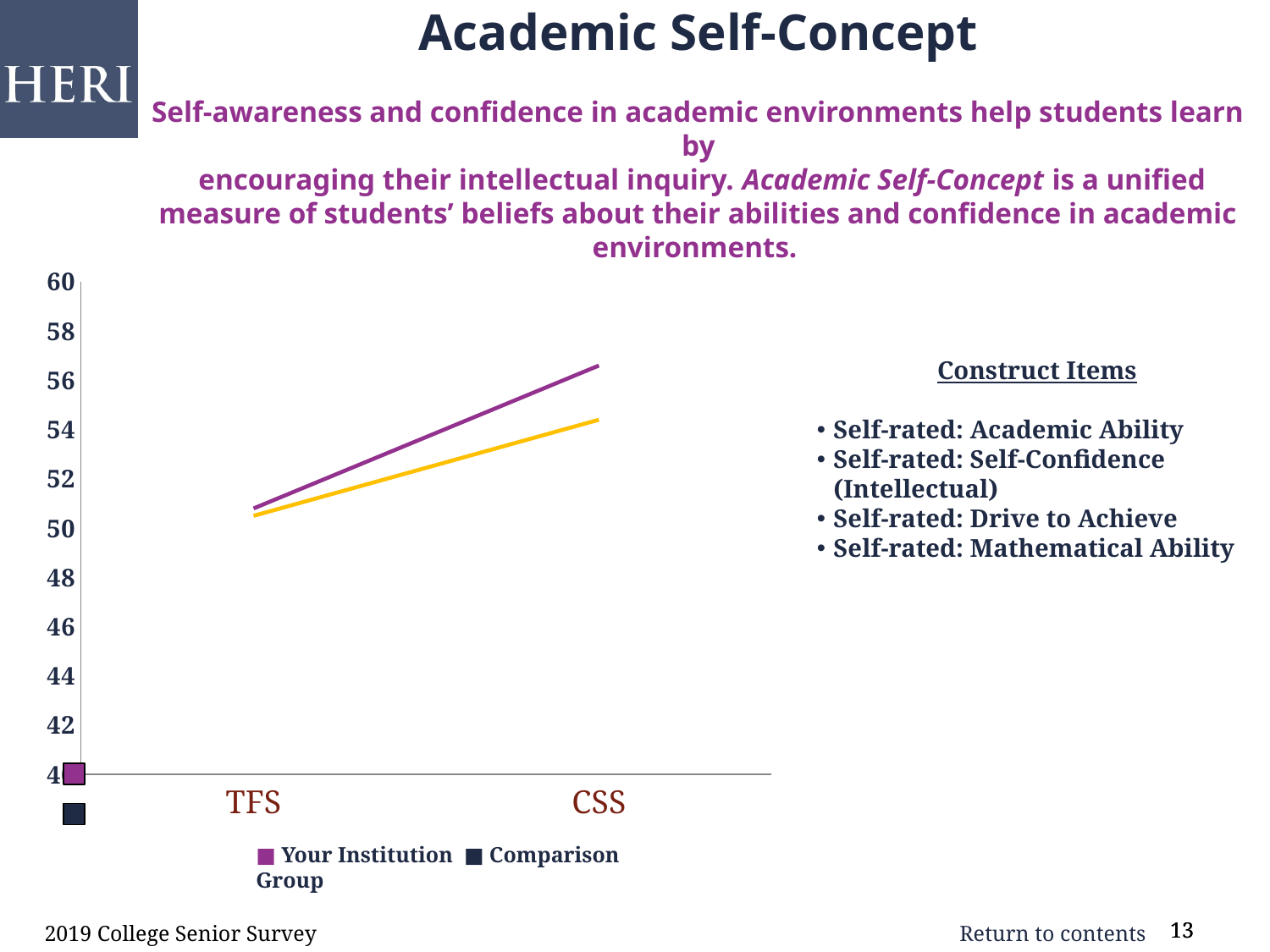
How many categories are shown on the x axis of the chart? 2 What are the two categories on the x axis of the chart? TFS and CSS What kind of chart is shown on the slide? line chart What is the title of the chart on the slide? Academic Self-Concept Is the value for Your Institution at CSS greater or less than 54? greater Is the value of the yellow line at TFS greater or less than 48? greater At CSS, which line is higher: the purple Your Institution line or the yellow line? the purple Your Institution line How many series does the chart legend list? 2 Does the yellow line rise or fall from TFS to CSS? rise Is the value of the yellow line at CSS greater or less than 56? less Does the Your Institution line rise or fall from TFS to CSS? rise